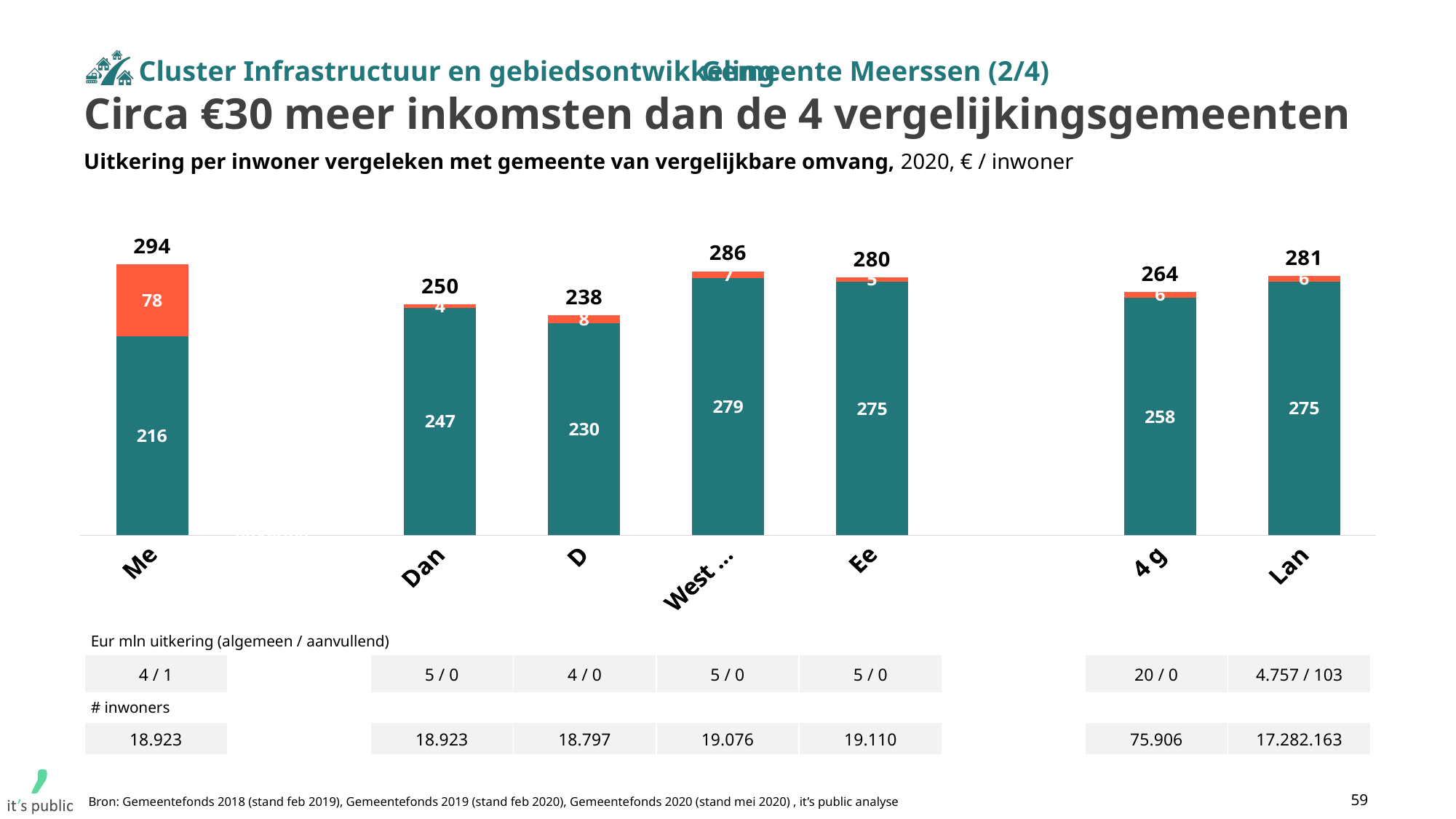
What is the value of the teal (lower) segment of the bar for Dan? 247 What is the difference between the total for Me (294) and the total for 4 g (264)? 30 What colour is the upper segment of each stacked bar? Orange What is the total value shown above the bar for Me? 294 What is the difference between the teal segment of Lan (275) and the teal segment of D (230)? 45 Which category has the highest total value? Me What is the total value shown above the bar for 4 g? 264 Which category has the lowest total value? D Which has a larger total value, West ... or Ee? West ... How many bars are plotted in the chart? 7 What is the value of the orange (upper) segment of the bar for Me? 78 What kind of chart is shown on the slide? Stacked bar chart